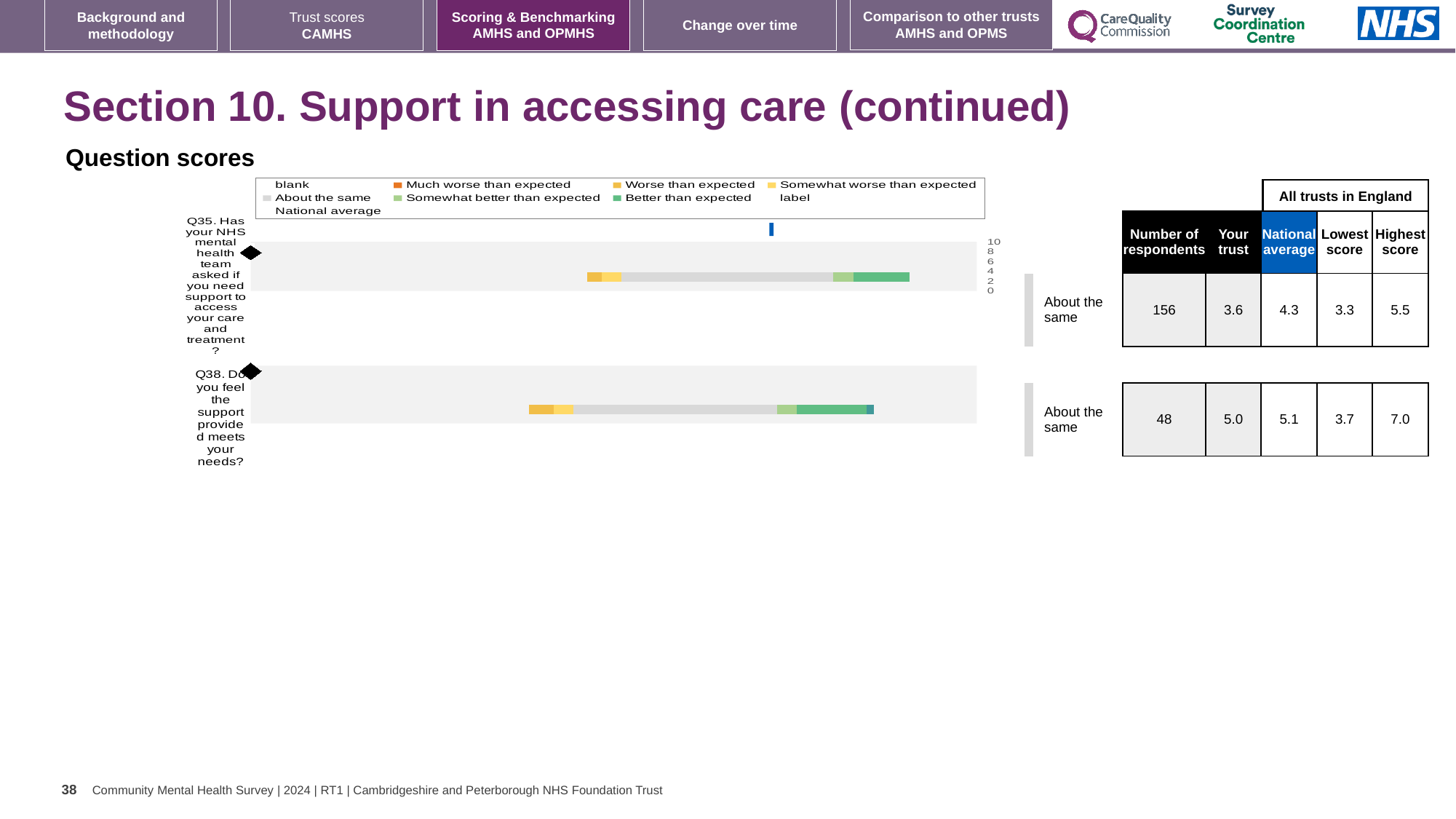
What is the benchmark category shown for Q38? About the same Which legend entry is shown in dark green? Better than expected What is the highest score among all trusts in England for Q38? 7.0 What is the difference between the national average and the trust score for Q35? 0.7 What is the number of respondents for Q35? 156 How many questions (categories) are plotted in the chart? 2 Which legend entry is shown in light grey? About the same What is the "Your trust" score for Q38? 5.0 What kind of chart is shown under "Question scores"? bar chart What is the national average for Q35? 4.3 How many entries does the chart legend list? 9 Which question has the higher "Your trust" score, Q35 or Q38? Q38